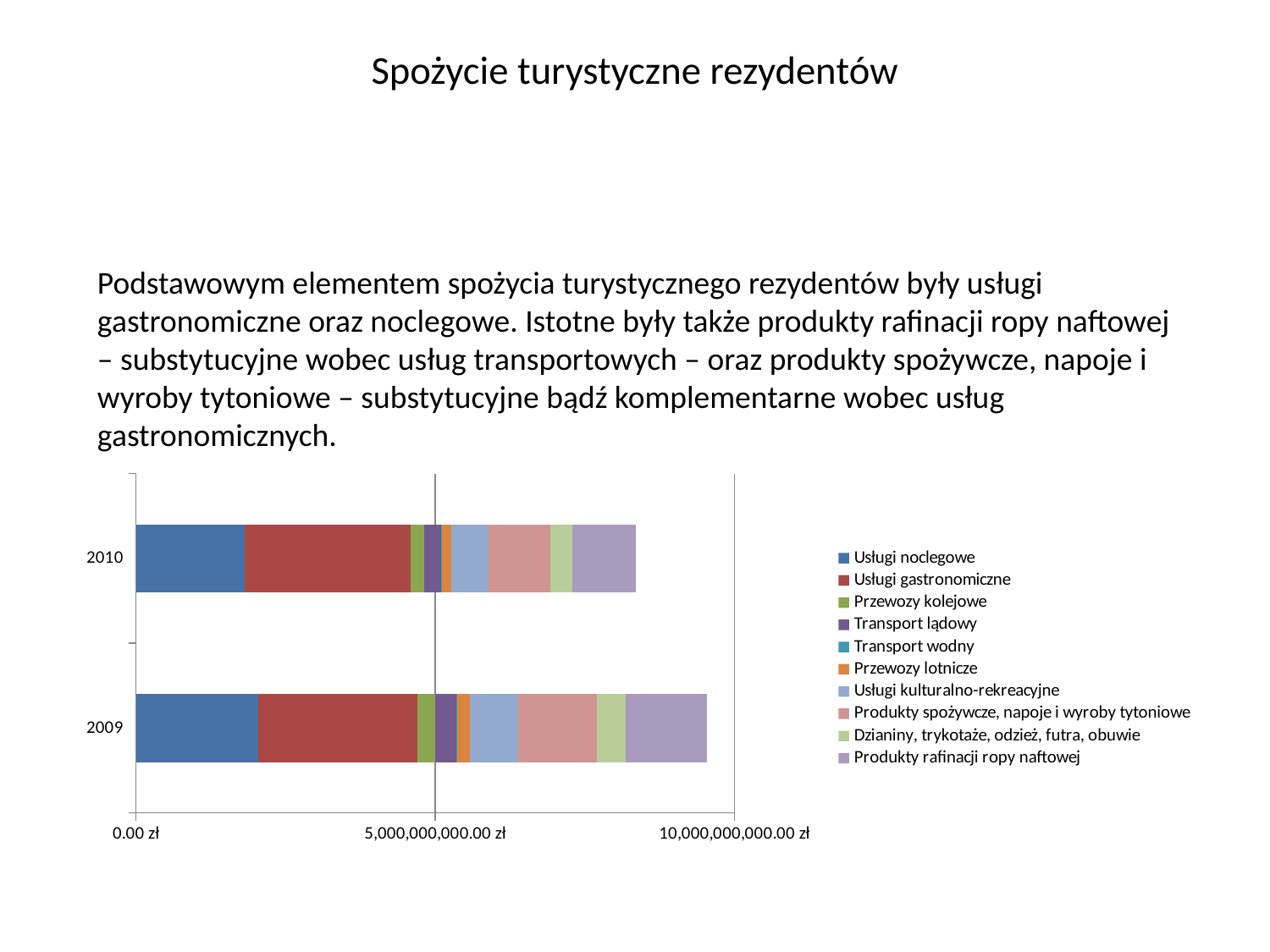
Which year has the larger total bar, 2009 or 2010? 2009 Is the total bar length for 2009 greater or less than 5,000,000,000.00 zł? greater What colour represents Usługi gastronomiczne in the chart? red Is the Usługi noclegowe segment for 2009 greater or less than 5,000,000,000.00 zł? less Is the total bar length for 2010 greater or less than 10,000,000,000.00 zł? less Which series forms the largest segment of the 2010 bar? Usługi gastronomiczne What kind of chart is shown on the slide? stacked bar chart How many years (categories) are plotted on the chart? 2 Which series is listed first in the chart legend? Usługi noclegowe How many series does the chart legend list? 10 Did the total tourist consumption of residents rise or fall from 2009 to 2010? fall